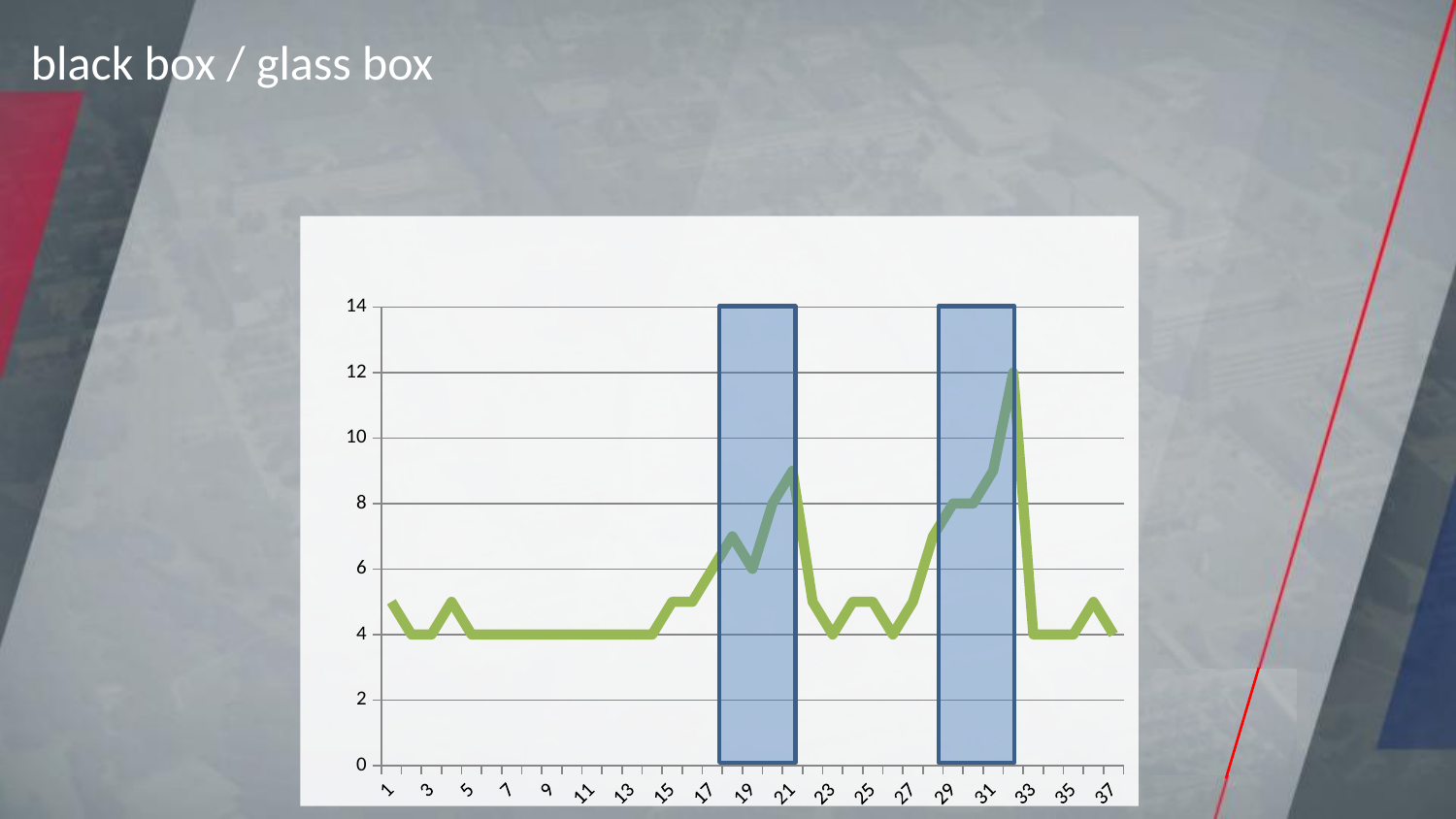
Is the value of the line at x = 21 greater or less than 8? greater What is the value of the line at x = 9? 4 How many labels are shown on the x axis? 19 How many shaded rectangles are overlaid on the chart? 2 What is the difference between the highest and lowest values of the line? 8 What kind of chart is shown on the slide? line chart What is the highest value reached by the line? 12 Which is larger, the value at x = 21 or the value at x = 33? x = 21 What is the value of the line at x = 33? 4 Is the value of the line at x = 1 greater or less than 4? greater What is the lowest value the line reaches? 4 Between x = 13 and x = 21, does the line generally rise or fall? rise